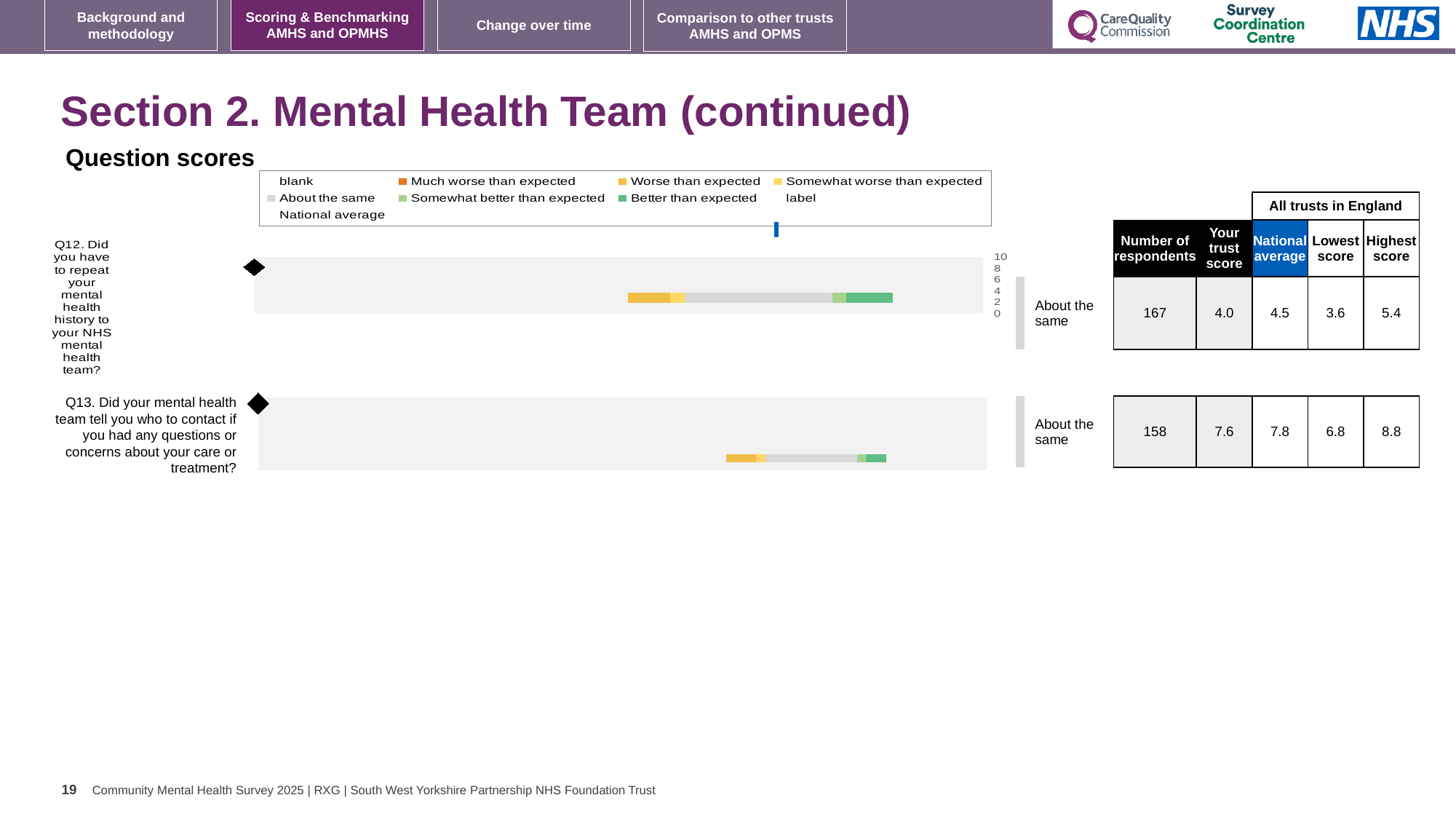
What kind of chart is used to show the question scores? Bar chart What benchmark category label is shown next to the Q12 chart? About the same How many questions are charted on this slide? 2 What is the national average score for Q12? 4.5 What is the trust score for Q12 (Did you have to repeat your mental health history to your NHS mental health team?)? 4.0 What is the lowest score among all trusts in England for Q12? 3.6 What is the highest score among all trusts in England for Q13? 8.8 For Q12, which is larger: the trust score or the national average? National average What is the trust score for Q13 (Did your mental health team tell you who to contact if you had any questions or concerns about your care or treatment?)? 7.6 How many respondents answered Q12? 167 What is the national average score for Q13? 7.8 For Q13, what is the difference between the highest score and the lowest score among all trusts in England? 2.0